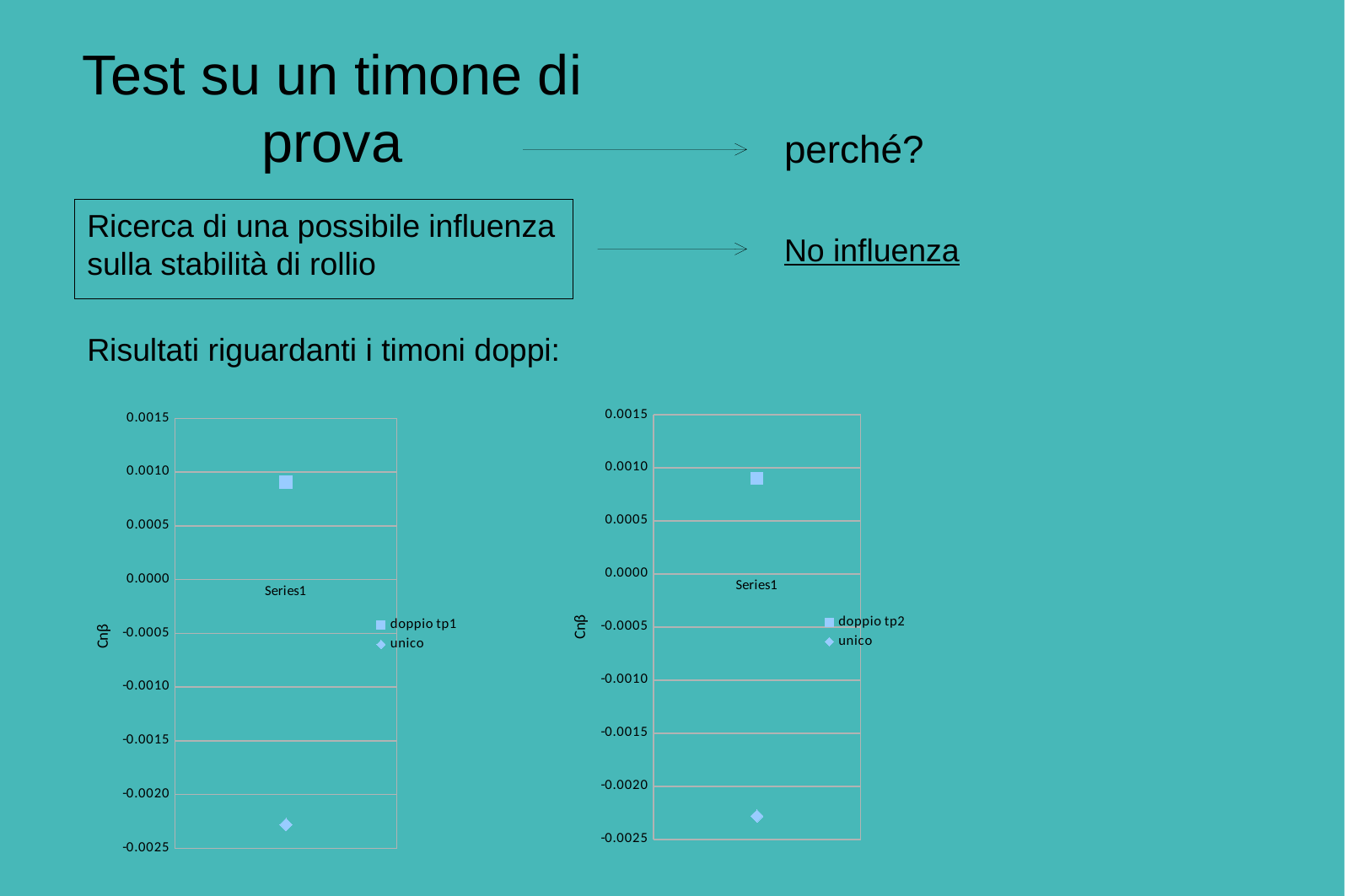
In the right chart, is the value for 'unico' greater or less than -0.0015? less In the right chart, is the value for 'doppio tp2' greater or less than 0.0000? greater What are the two legend entries in the right chart? doppio tp2 and unico In the left chart, is the value for 'unico' greater or less than -0.0020? less In the right chart, which series has the lower value, 'doppio tp2' or 'unico'? unico In the left chart, which series has the larger value, 'doppio tp1' or 'unico'? doppio tp1 What kind of chart is the left chart? scatter chart What is the label on the vertical axis of the left chart? Cnβ In the right chart, how many series does the legend list? 2 In the left chart, how many series does the legend list? 2